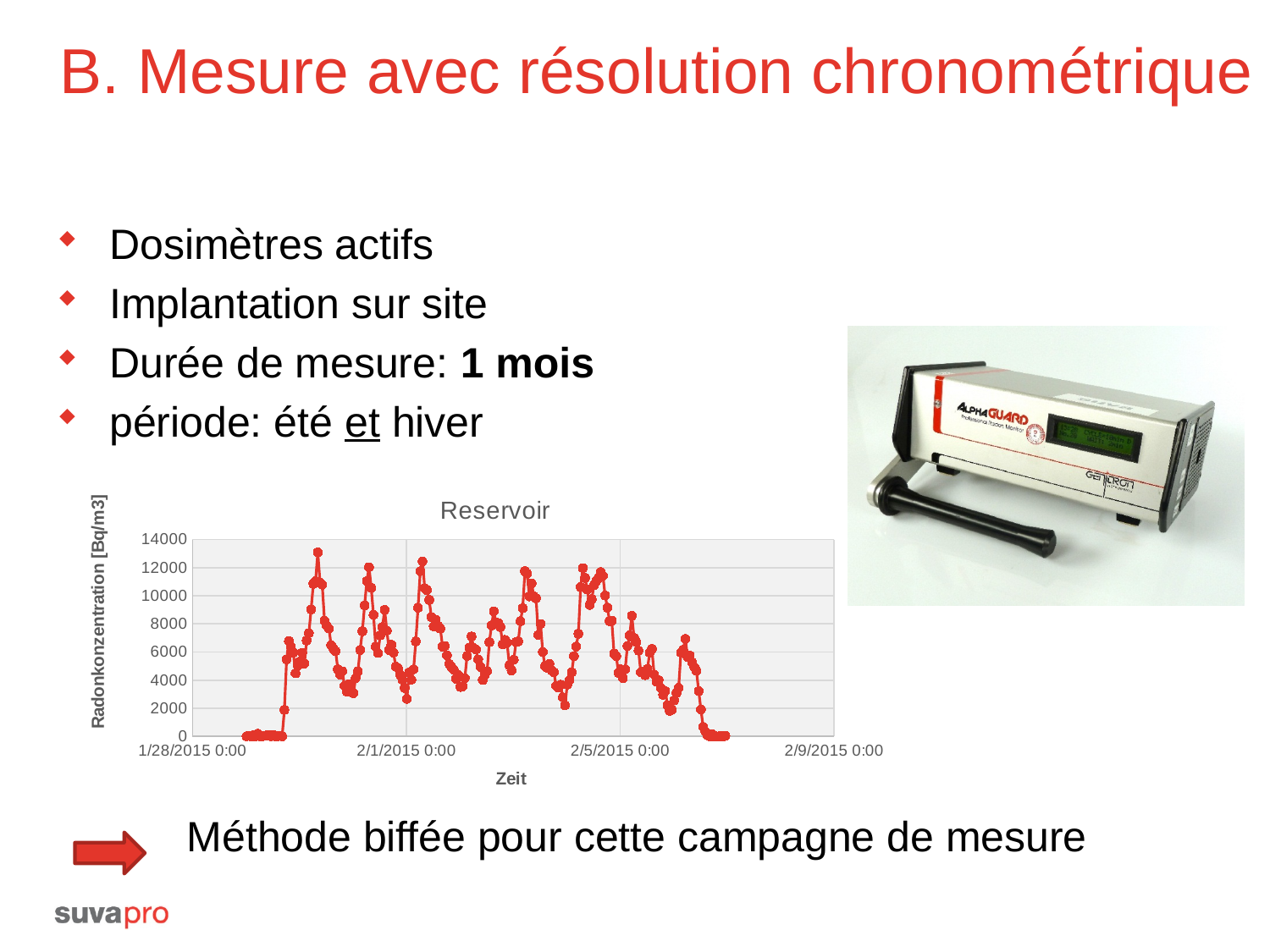
What kind of chart is shown on the slide? line chart What is the last date shown on the horizontal axis of the chart? 2/9/2015 0:00 Is the highest peak of the radon concentration greater or less than 12000? greater What is the first date shown on the horizontal axis of the chart? 1/28/2015 0:00 What is the label of the vertical axis of the chart? Radonkonzentration [Bq/m3] Is the radon concentration at the end of the measurement (after 2/7/2015) greater or less than 2000? less Does the radon concentration rise or fall between 1/28/2015 and the first peak around 1/30/2015? rise What is the title of the chart on the slide? Reservoir Is the highest peak of the radon concentration greater or less than 14000? less What is the highest value shown on the vertical axis of the chart? 14000 Does the radon concentration rise or fall over the last days of the measurement, approaching 2/7/2015? fall